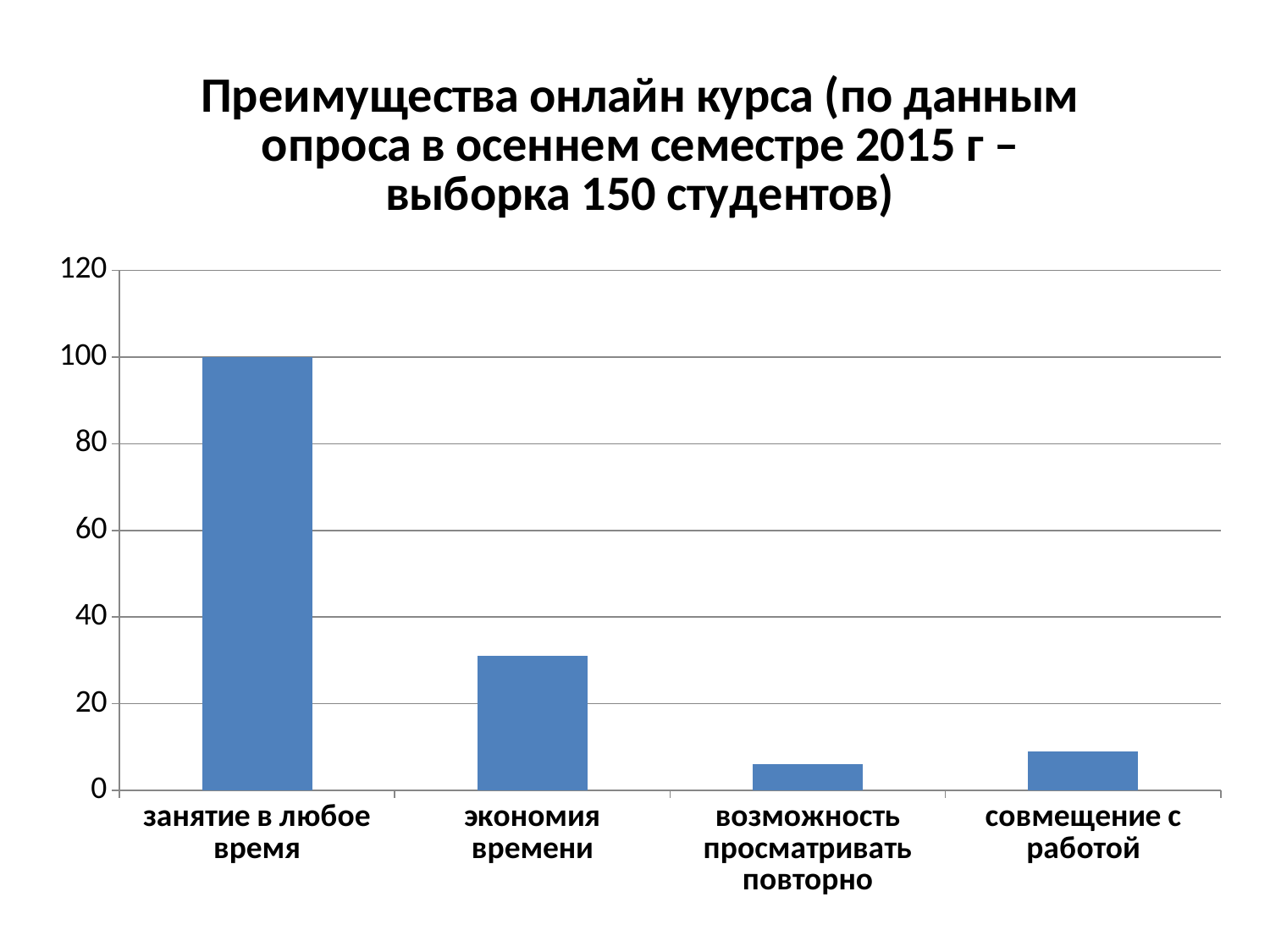
Is the value for "экономия времени" greater or less than 40? less Which is larger, the value for "экономия времени" or the value for "совмещение с работой"? экономия времени Is the value for "экономия времени" greater or less than 20? greater What is the value for "занятие в любое время"? 100 What is the maximum value shown on the vertical axis of the chart? 120 Is the value for "совмещение с работой" greater or less than 20? less Which category has the lowest bar? возможность просматривать повторно Which category has the highest bar? занятие в любое время What kind of chart is shown on the slide? bar chart How many categories are shown on the x axis of the chart? 4 Which is larger, the value for "совмещение с работой" or the value for "возможность просматривать повторно"? совмещение с работой